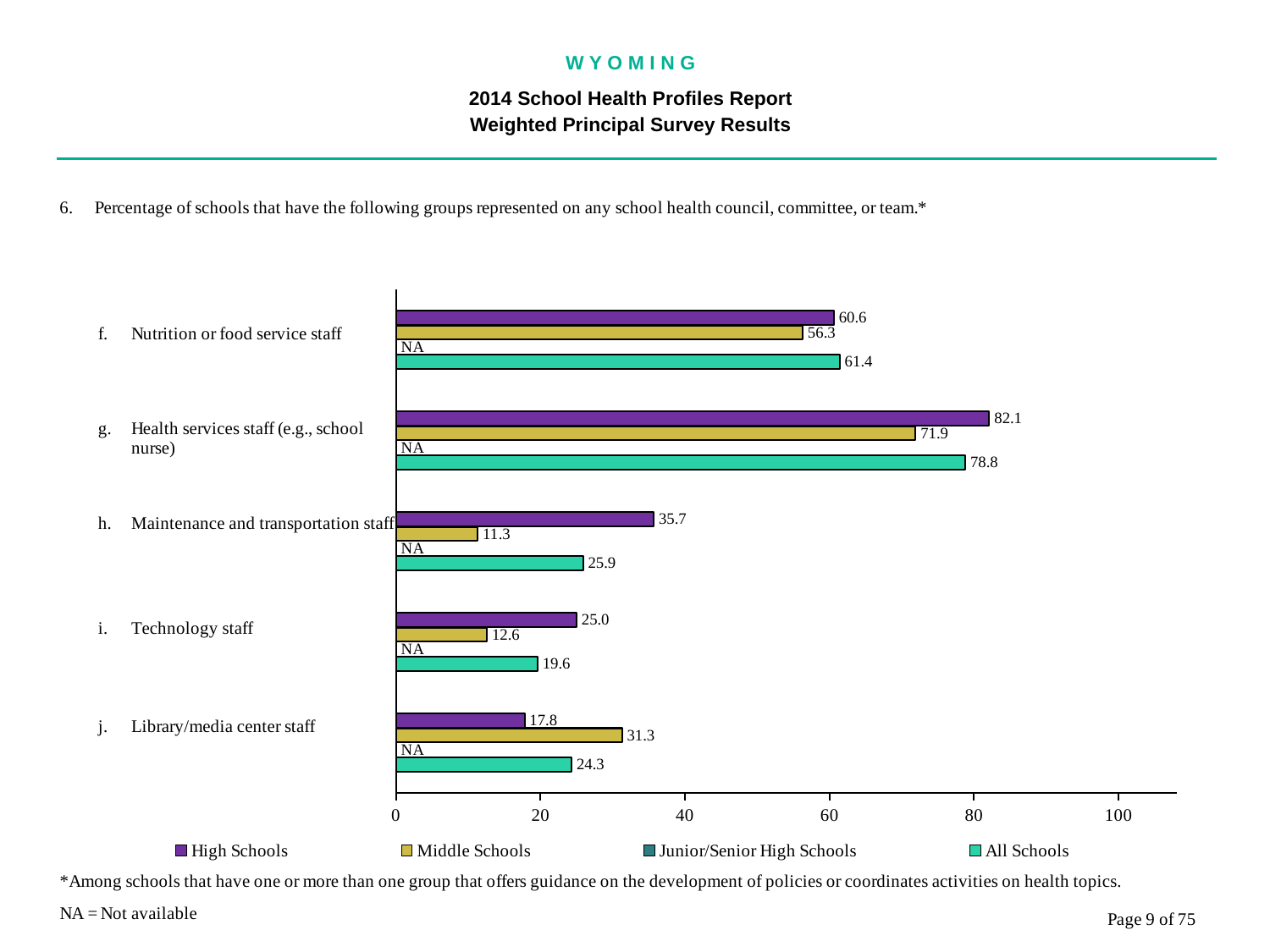
What does NA stand for according to the note on the slide? Not available How many groups (categories) are shown on the chart? 5 Which group has the highest value for All Schools? Health services staff (e.g., school nurse) For Library/media center staff, which is larger: the High Schools value or the Middle Schools value? Middle Schools What is the value for Middle Schools for Library/media center staff? 31.3 What is the All Schools value for Technology staff? 19.6 What kind of chart is shown on the slide? Bar chart What value is shown for Junior/Senior High Schools for Nutrition or food service staff? NA What is the difference between the High Schools and Middle Schools values for Maintenance and transportation staff? 24.4 What percentage of high schools have health services staff represented on a school health council, committee, or team? 82.1 How many series does the legend list? 4 Which group has the lowest value for High Schools? Library/media center staff